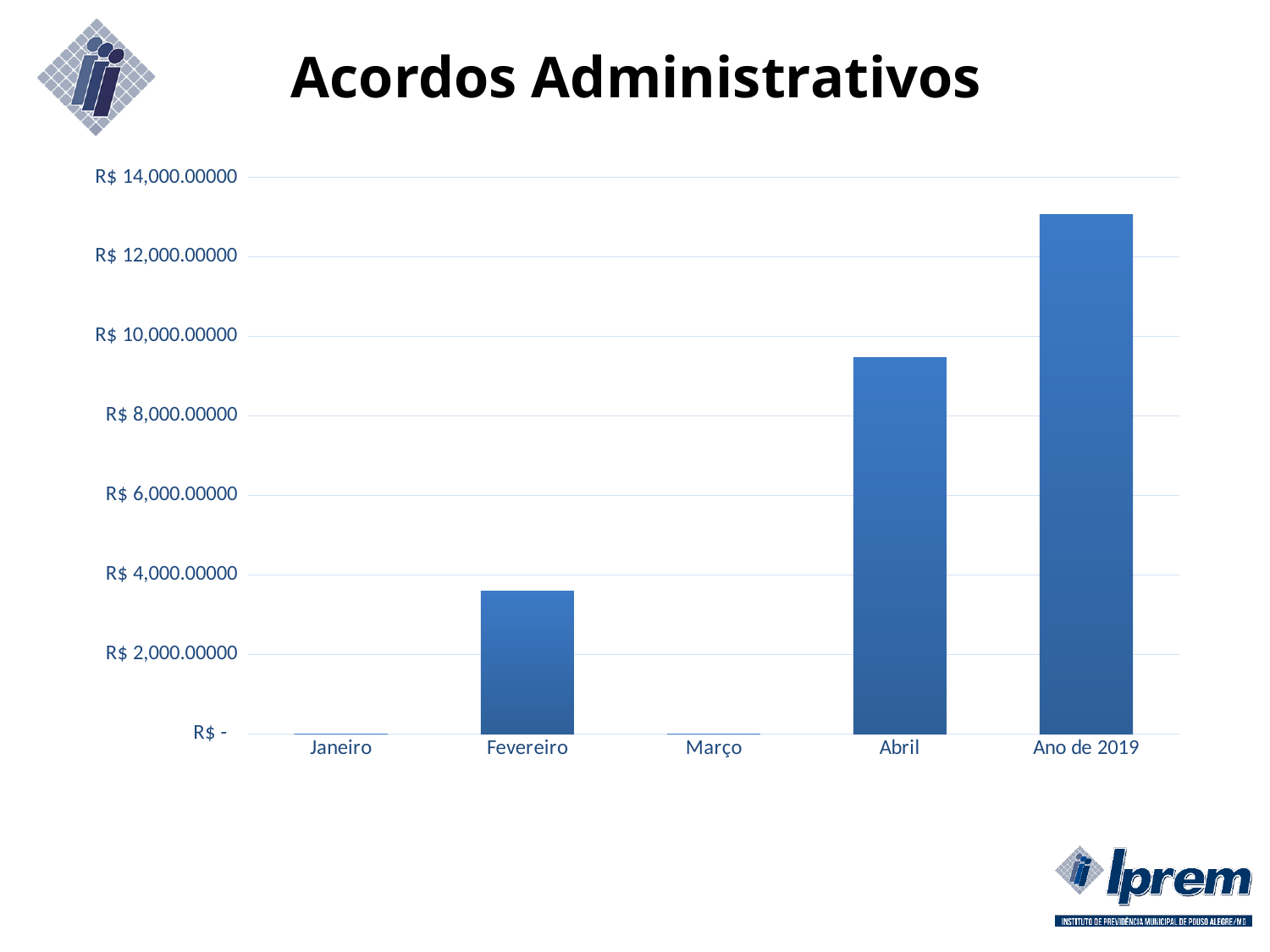
Is the value for Fevereiro greater or less than R$ 2,000.00000? greater Which is larger, the value for Fevereiro or the value for Abril? Abril What kind of chart is shown on the slide? Bar chart How many categories are shown on the x axis? 5 Is the value for Março greater or less than R$ 2,000.00000? less Is the value for Fevereiro greater or less than R$ 4,000.00000? less What is the title of the chart? Acordos Administrativos Which is larger, the value for Abril or the value for Ano de 2019? Ano de 2019 Which category has the highest value? Ano de 2019